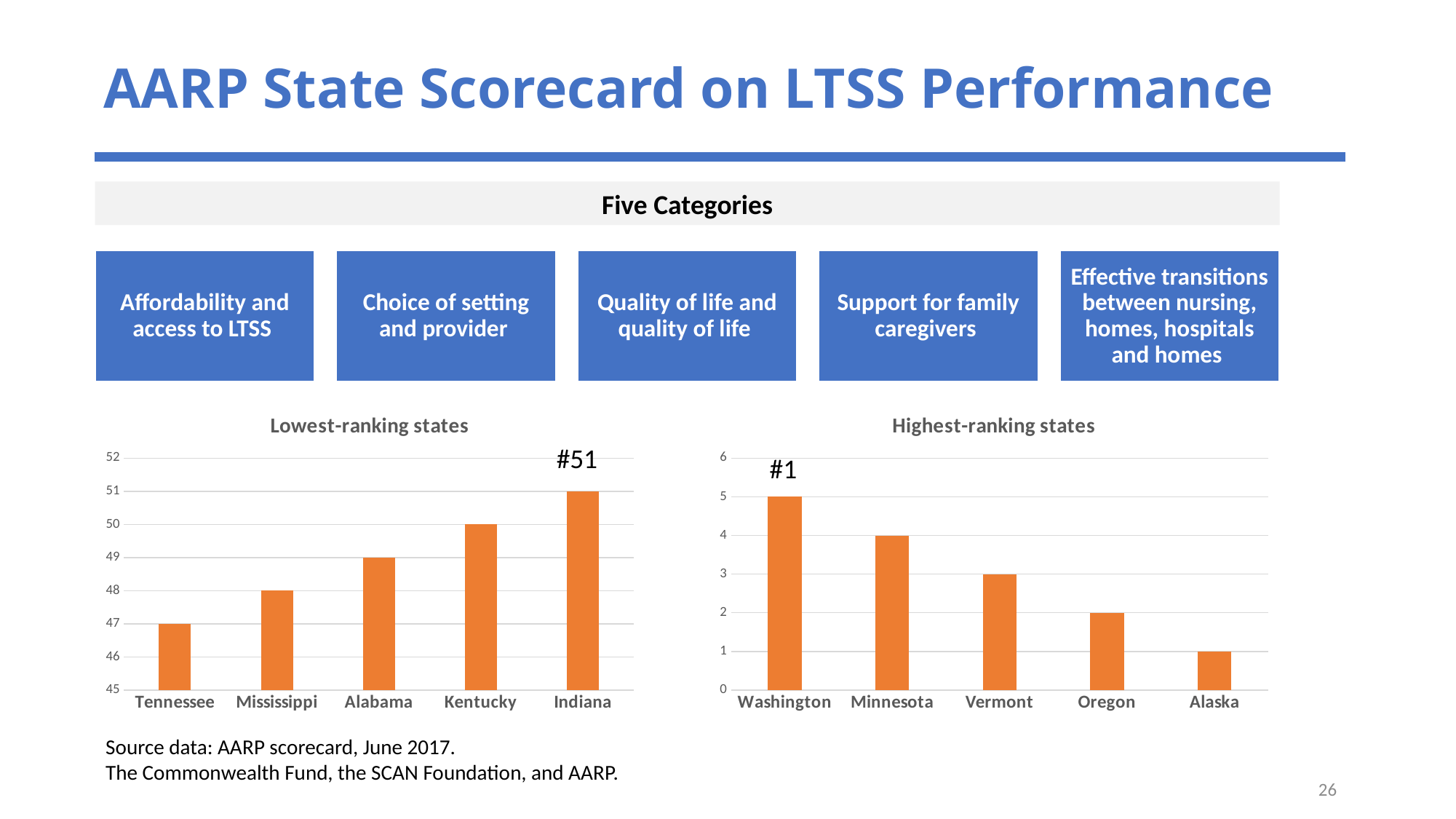
What kind of chart is the 'Lowest-ranking states' chart? Bar chart In the 'Highest-ranking states' chart, what is the value for Washington? 5 In the 'Highest-ranking states' chart, which state has the lowest bar? Alaska In the 'Highest-ranking states' chart, do the values rise or fall from left to right? Fall In the 'Lowest-ranking states' chart, what is the value for Tennessee? 47 In the 'Lowest-ranking states' chart, which state has the highest bar? Indiana In the 'Highest-ranking states' chart, what is the value for Alaska? 1 In the 'Lowest-ranking states' chart, what is the difference between the values for Indiana and Tennessee? 4 In the 'Lowest-ranking states' chart, what rank label is printed above the Indiana bar? #51 How many states are shown in the 'Highest-ranking states' chart? 5 In the 'Lowest-ranking states' chart, what is the value for Indiana? 51 In the 'Highest-ranking states' chart, which is larger, the value for Minnesota or the value for Oregon? Minnesota